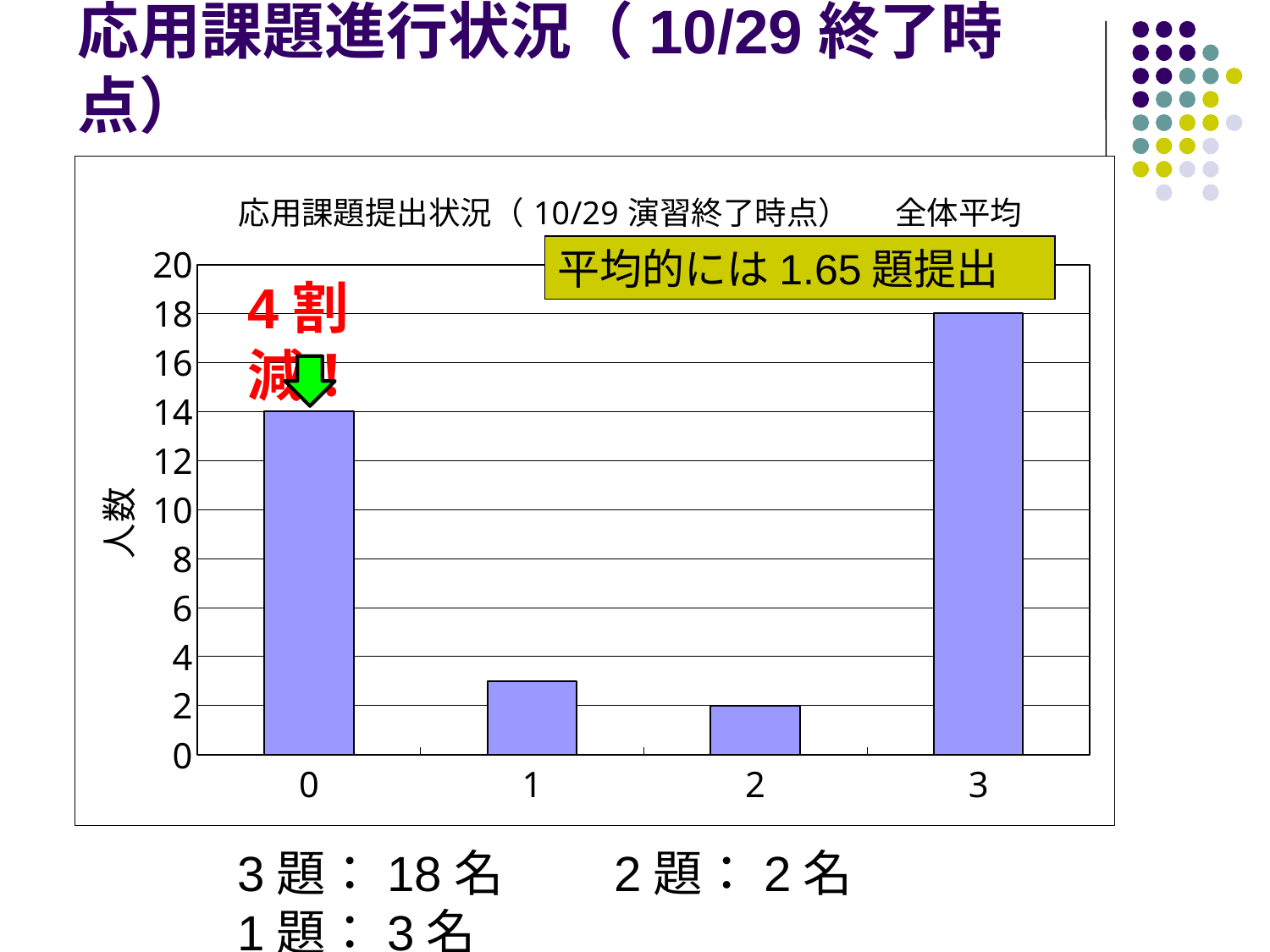
Which is larger, the value for category 1 or the value for category 2? category 1 Is the value for category 0 greater or less than 10? greater What is the value (人数) for category 1? 3 What is the value (人数) for category 2? 2 What is the value (人数) for category 3? 18 Which category has the highest value? 3 Which category has the lowest value? 2 What is the label of the y axis of the chart? 人数 What type of chart is shown on the slide? bar chart What is the value (人数) for category 0? 14 How many categories are shown on the x axis of the chart? 4 What is the difference between the values for category 3 and category 0? 4